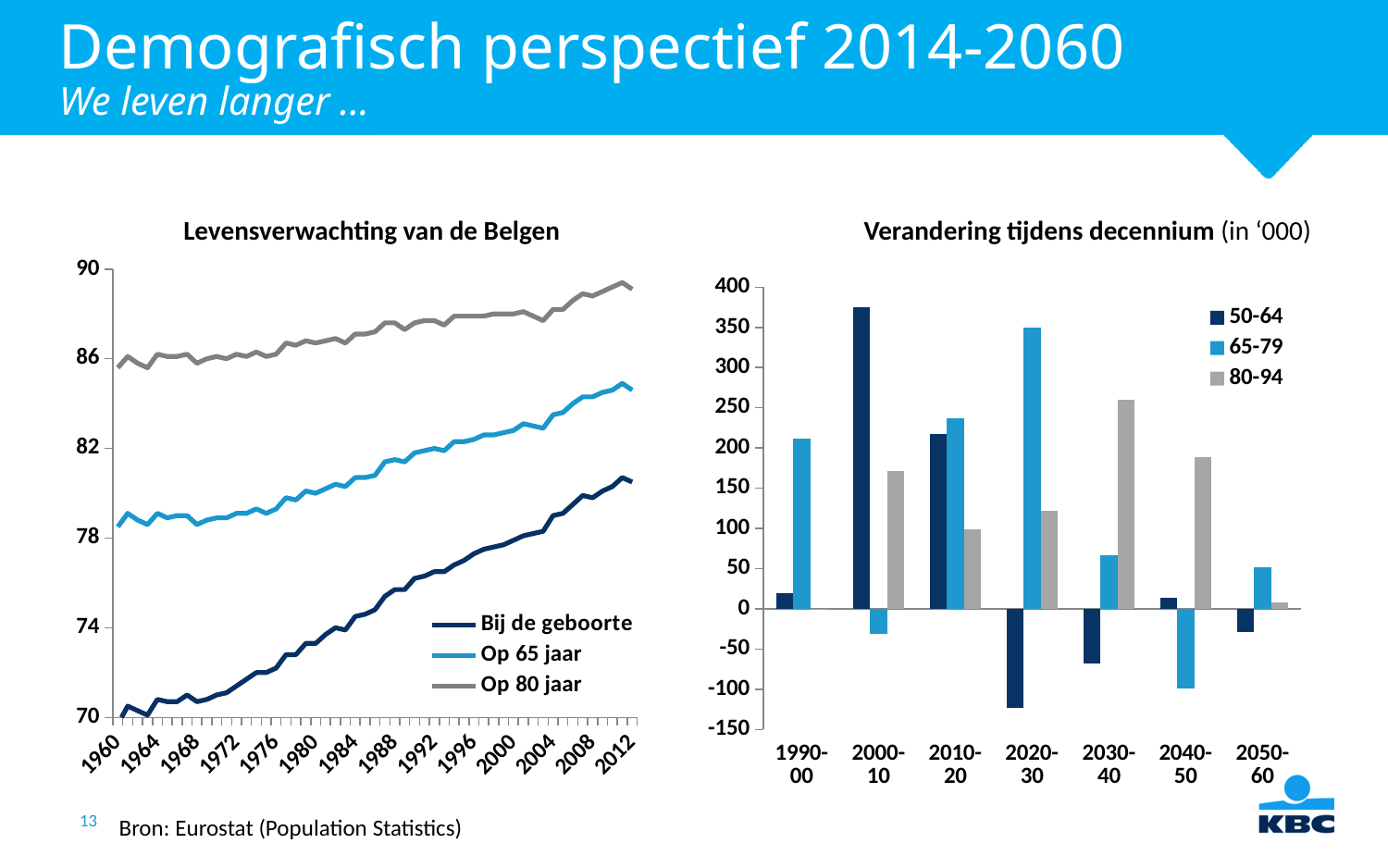
In the right chart 'Verandering tijdens decennium', in which decade is the '65-79' bar lowest? 2040-50 In the right chart 'Verandering tijdens decennium', in which decade is the '50-64' bar highest? 2000-10 How many series does the legend of the left chart 'Levensverwachting van de Belgen' list? 3 In the right chart 'Verandering tijdens decennium', is the '50-64' value for 2000-10 greater or less than 350? greater How many decade categories are shown on the x axis of the right chart 'Verandering tijdens decennium'? 7 What kind of chart is the left chart, 'Levensverwachting van de Belgen'? line chart In the left chart 'Levensverwachting van de Belgen', is the value of 'Bij de geboorte' in 1960 greater or less than 74? less In the left chart 'Levensverwachting van de Belgen', is the value of 'Op 65 jaar' in 2012 greater or less than 82? greater What kind of chart is the right chart, 'Verandering tijdens decennium'? bar chart In the right chart 'Verandering tijdens decennium', which is larger for 1990-00: the '50-64' bar or the '65-79' bar? 65-79 In the left chart 'Levensverwachting van de Belgen', do the values of 'Bij de geboorte' rise or fall from 1960 to 2012? rise In the left chart 'Levensverwachting van de Belgen', which series has the highest values throughout the period? Op 80 jaar